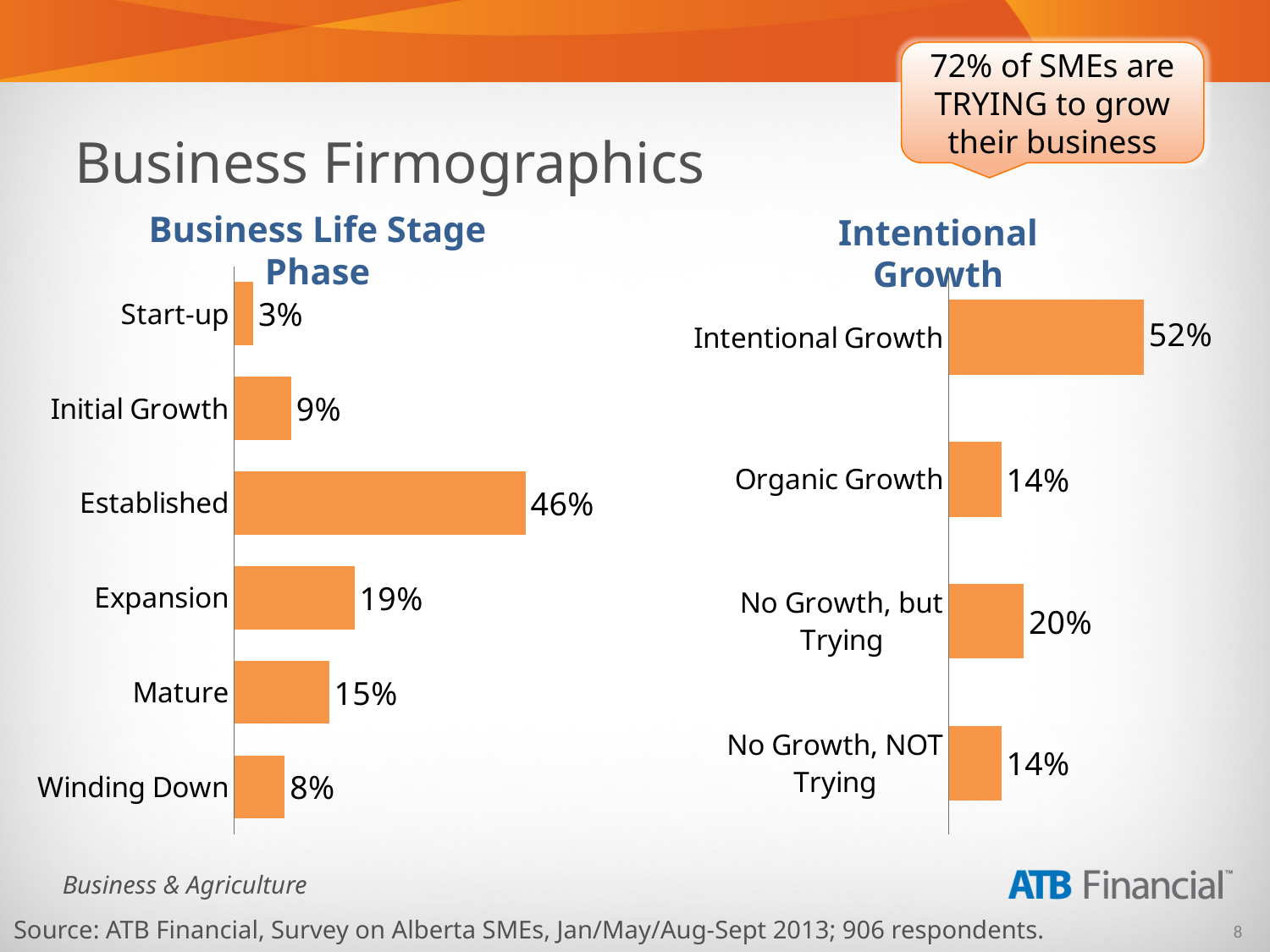
In the Business Life Stage Phase chart, what is the value for Established? 46% In the Business Life Stage Phase chart, what is the difference between Expansion and Mature? 4% How many categories does the Business Life Stage Phase chart show? 6 In the Business Life Stage Phase chart, what is the value for Winding Down? 8% What is the title of the chart on the left of the slide? Business Life Stage Phase In the Intentional Growth chart, what is the value for No Growth, but Trying? 20% How many categories does the Intentional Growth chart show? 4 In the Business Life Stage Phase chart, which is larger, Initial Growth or Winding Down? Initial Growth What kind of chart is the Intentional Growth chart? Bar chart In the Intentional Growth chart, what is the difference between Intentional Growth and Organic Growth? 38% In the Business Life Stage Phase chart, which category has the lowest value? Start-up In the Intentional Growth chart, which category has the highest value? Intentional Growth